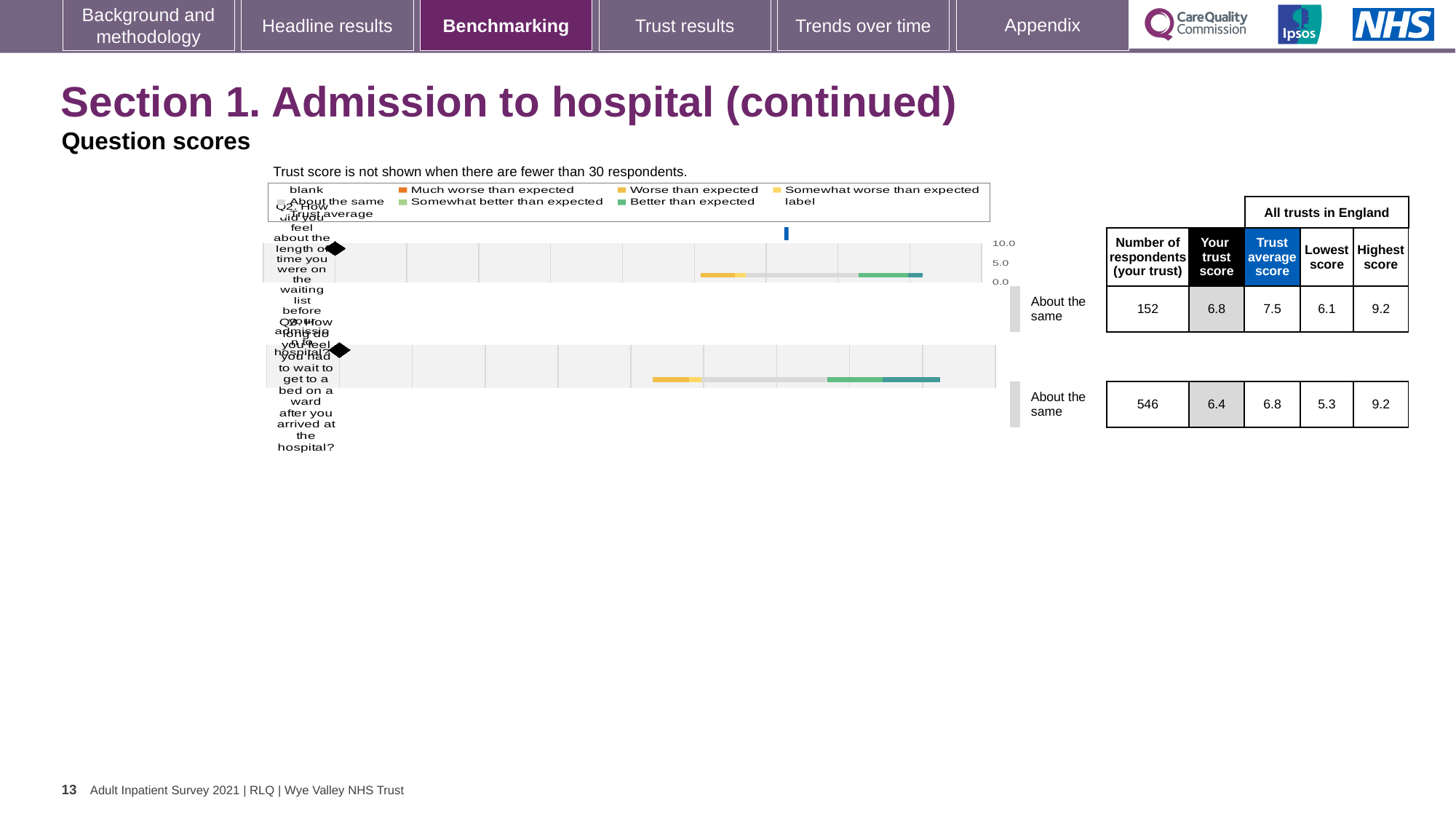
What is the difference between the Trust average score and Your trust score for Q2? 0.7 Which question has the higher 'Your trust score', Q2 or Q3? Q2 What is the 'Your trust score' for Q3? 6.4 What is the Highest score across all trusts in England for Q2? 9.2 What is the Trust average score for Q3? 6.8 What is the 'Your trust score' for Q2? 6.8 What benchmark category is shown next to the Q3 chart? About the same What is the maximum value shown on the score axis of the charts? 10.0 What is the Lowest score across all trusts in England for Q3? 5.3 How many respondents (your trust) are shown for Q2? 152 What kind of chart is used to show the question scores on this slide? bar chart How many questions (bars) are plotted on the slide? 2